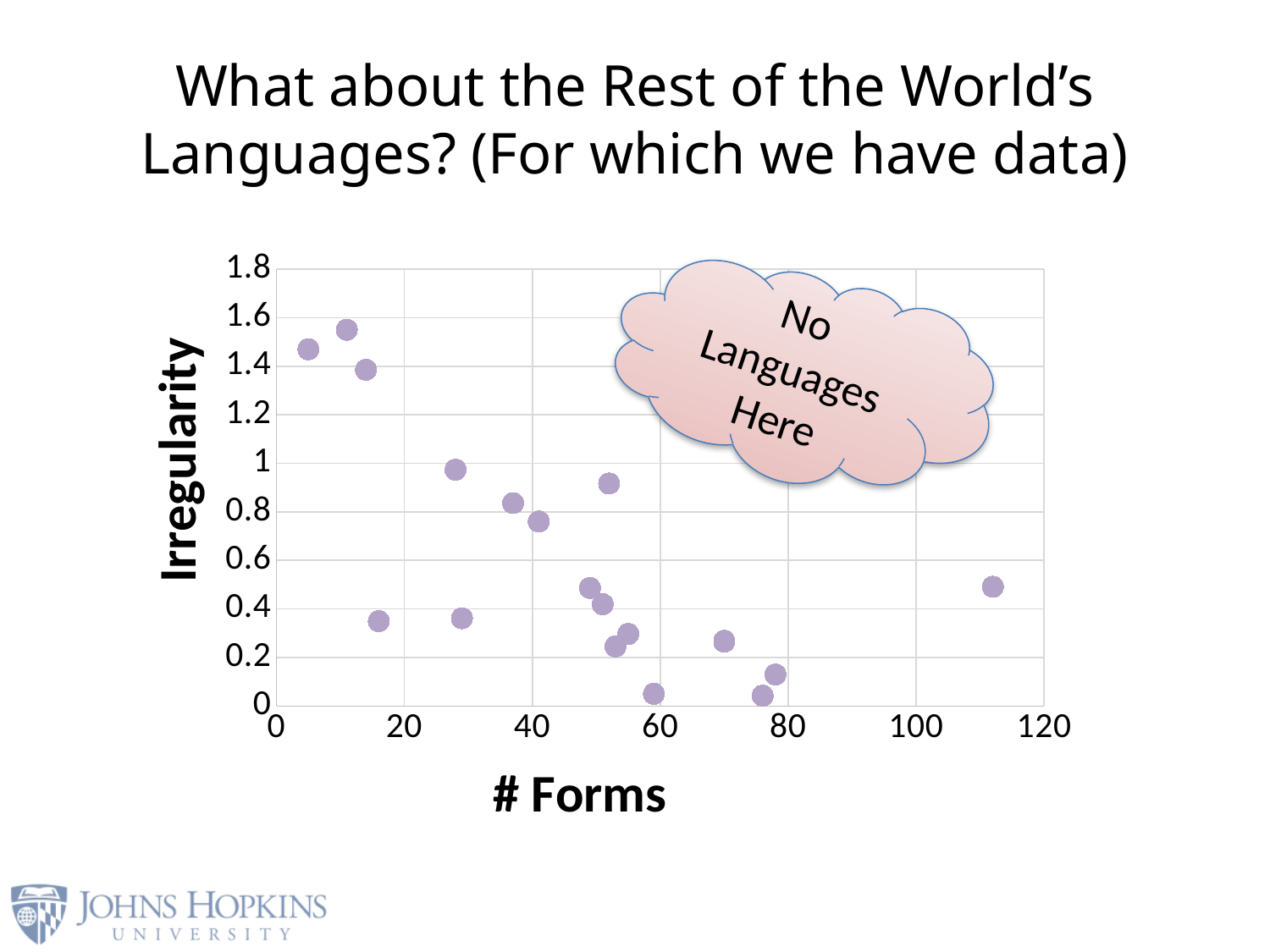
What is the label of the x axis of the chart? # Forms What kind of chart is shown on the slide? scatter plot Is the Irregularity value of the point with the largest # Forms greater or less than 0.6? less What is the maximum value shown on the y axis? 1.8 Is the lowest Irregularity value plotted greater or less than 0.2? less Do the points with the highest Irregularity values have # Forms greater or less than 20? less What is the maximum value shown on the x axis? 120 Overall, does Irregularity tend to rise or fall as # Forms increases? fall